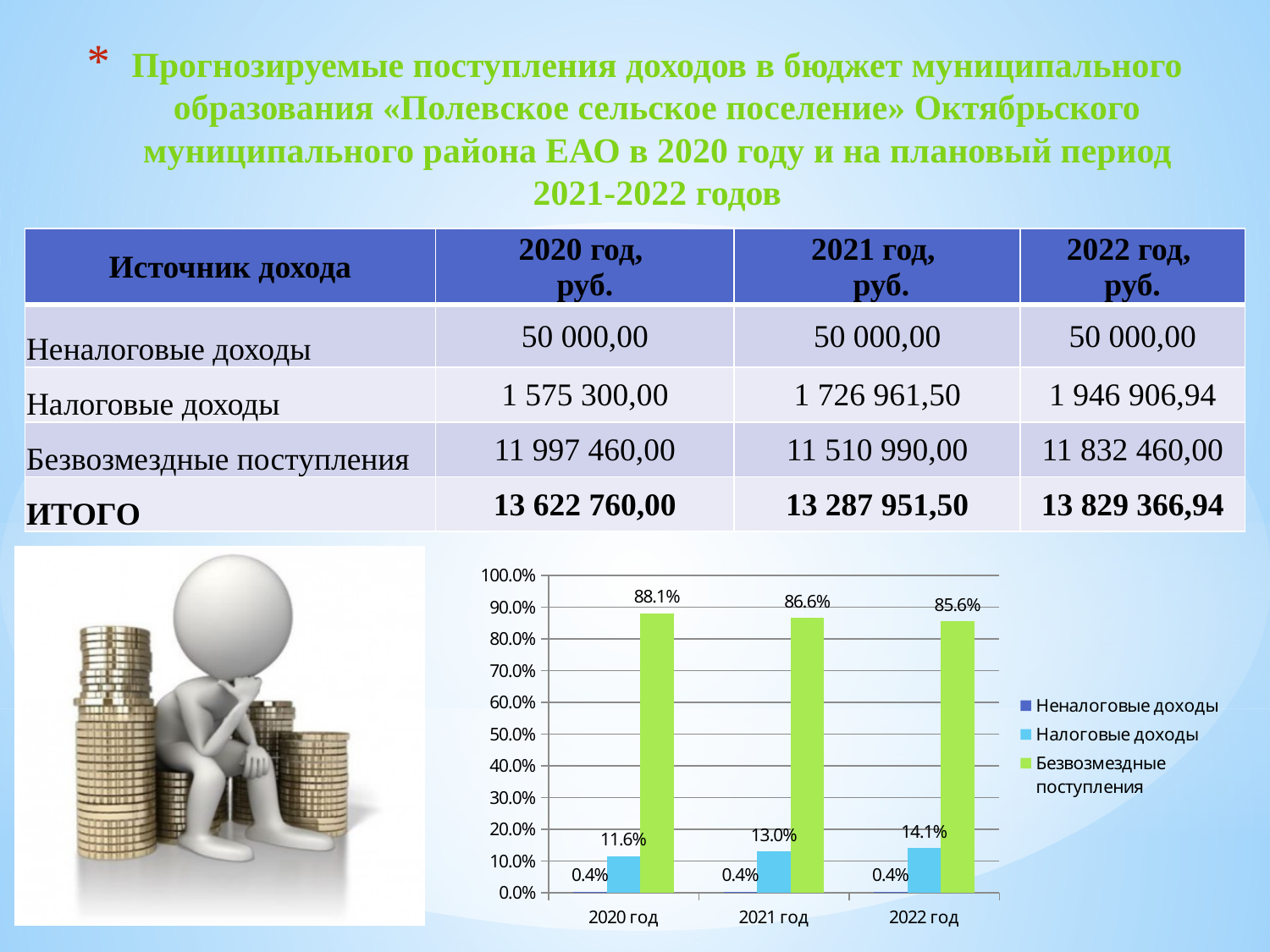
What is the value for Неналоговые доходы in 2021 год on the chart? 0.4% Which is larger on the chart: Налоговые доходы in 2020 год or Налоговые доходы in 2021 год? Налоговые доходы in 2021 год What is the value for Безвозмездные поступления in 2020 год on the chart? 88.1% In which year is the value for Налоговые доходы the highest on the chart? 2022 год Which series is shown in green on the chart? Безвозмездные поступления Does the value for Безвозмездные поступления rise or fall from 2020 год to 2022 год on the chart? fall What is the value for Налоговые доходы in 2022 год on the chart? 14.1% What type of chart is shown on the slide? bar chart How many year categories are shown on the x axis of the chart? 3 What is the difference between the Безвозмездные поступления values for 2020 год and 2022 год on the chart? 2.5% How many series does the chart legend list? 3 In which year is the value for Безвозмездные поступления the lowest on the chart? 2022 год